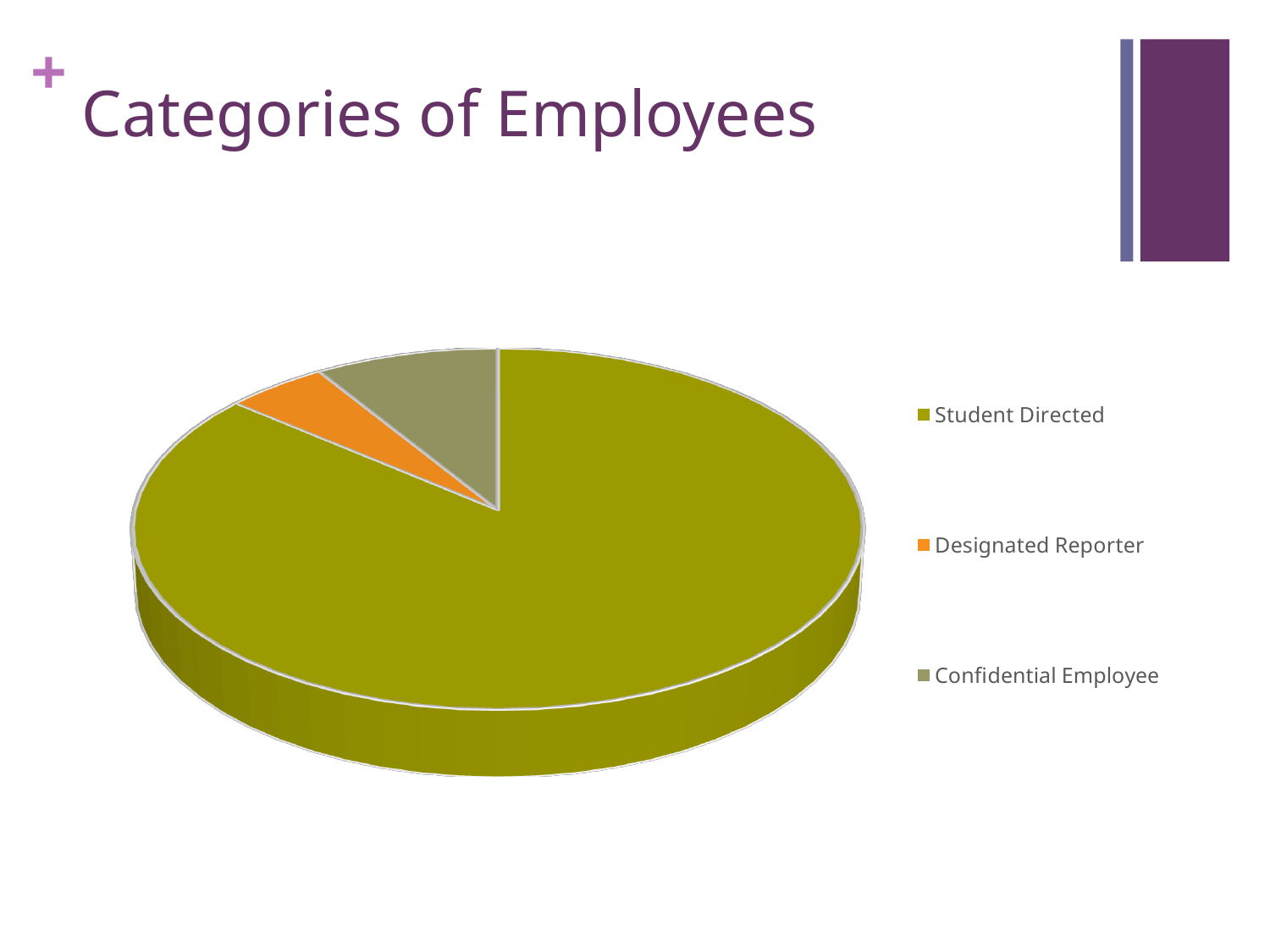
Which slice is larger, Student Directed or Confidential Employee? Student Directed Which slice is larger, Confidential Employee or Designated Reporter? Confidential Employee Which category has the smallest slice of the pie? Designated Reporter What colour is the Designated Reporter slice in the pie chart? Orange Which category has the largest slice of the pie? Student Directed Does the Student Directed slice take up more or less than half of the pie? More How many categories does the pie chart show? 3 Which category is listed first in the legend? Student Directed What is the title of the chart on the slide? Categories of Employees What kind of chart is shown on the slide? Pie chart